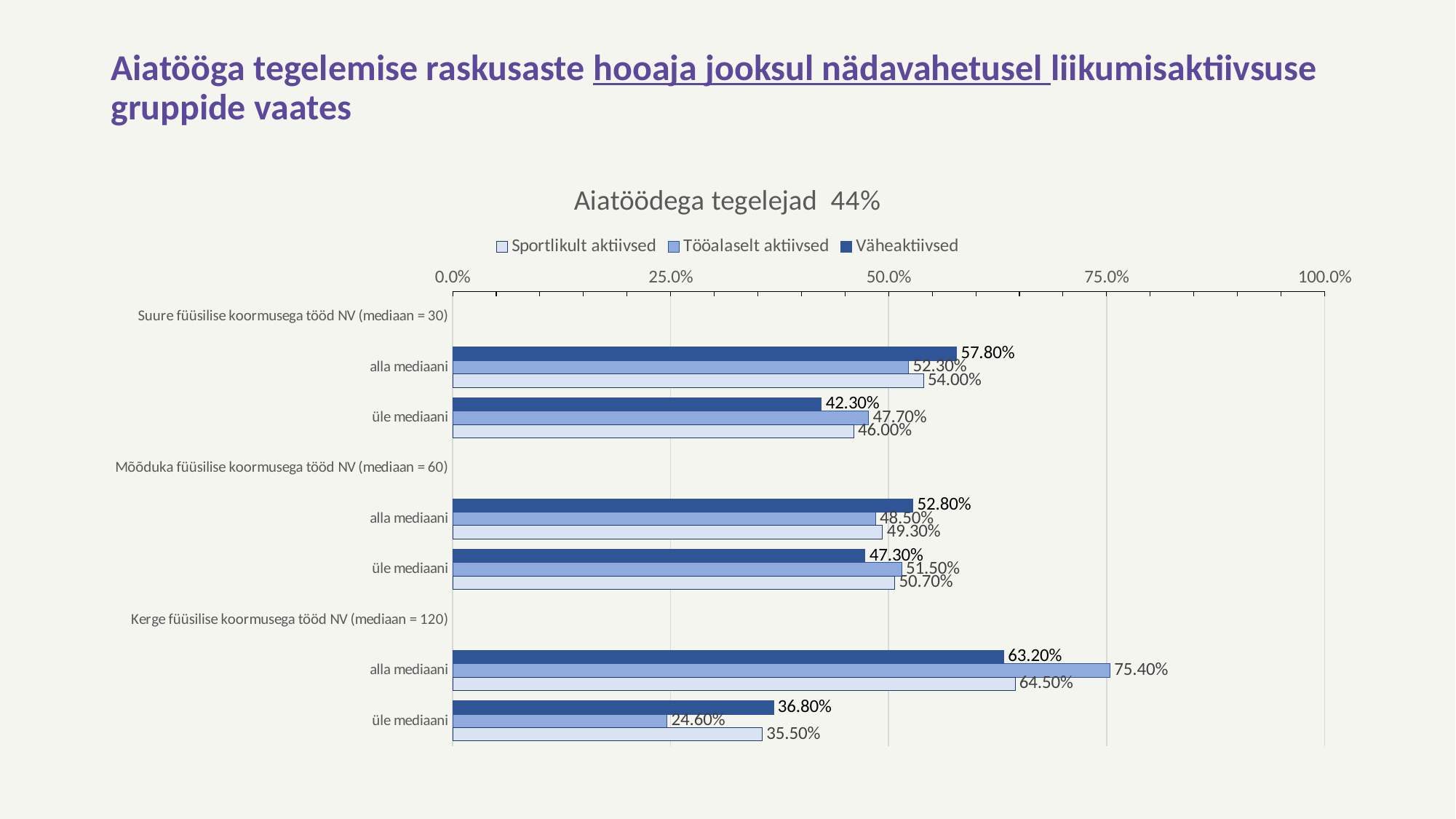
Under 'Suure füüsilise koormusega tööd NV (mediaan = 30)', 'üle mediaani' row, which is larger: Tööalaselt aktiivsed or Väheaktiivsed? Tööalaselt aktiivsed How many series does the legend list? 3 What is the value for Sportlikult aktiivsed in the 'üle mediaani' row under 'Mõõduka füüsilise koormusega tööd NV (mediaan = 60)'? 50.70% Is the value for Tööalaselt aktiivsed in the 'alla mediaani' row under 'Kerge füüsilise koormusega tööd NV (mediaan = 120)' greater or less than 75.0%? greater What is the difference between the Väheaktiivsed values for 'alla mediaani' and 'üle mediaani' under 'Kerge füüsilise koormusega tööd NV (mediaan = 120)'? 26.40% Which legend entry is shown with the darkest blue colour? Väheaktiivsed What is the value for Tööalaselt aktiivsed in the 'alla mediaani' row under 'Kerge füüsilise koormusega tööd NV (mediaan = 120)'? 75.40% Which series has the lowest value in the 'üle mediaani' row under 'Kerge füüsilise koormusega tööd NV (mediaan = 120)'? Tööalaselt aktiivsed What is the value for Väheaktiivsed in the 'alla mediaani' row under 'Suure füüsilise koormusega tööd NV (mediaan = 30)'? 57.80% What type of chart is shown on the slide? bar chart Which series has the highest value in the 'alla mediaani' row under 'Suure füüsilise koormusega tööd NV (mediaan = 30)'? Väheaktiivsed What is the title of the chart? Aiatöödega tegelejad 44%